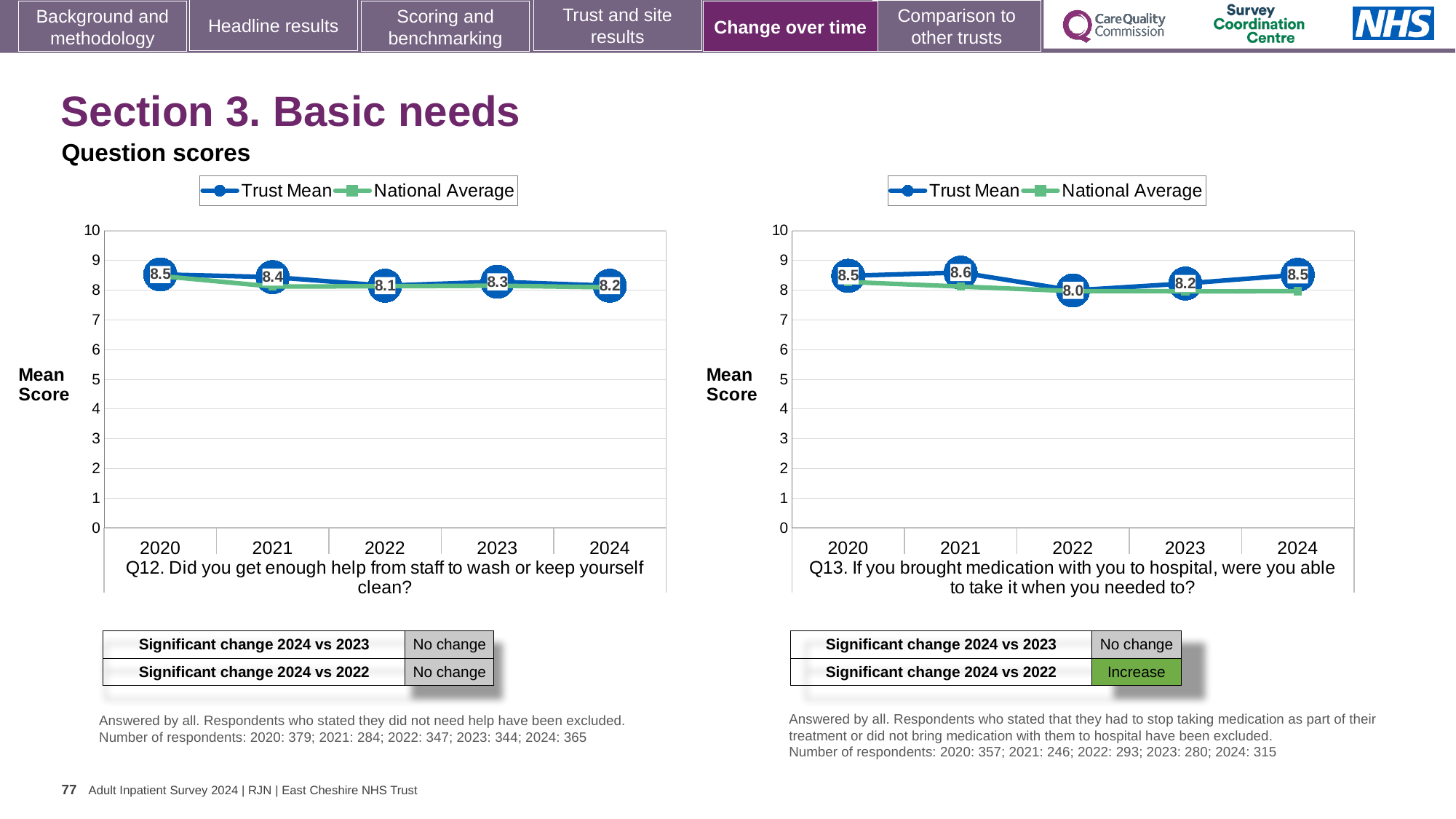
In the Q13 chart, what is the difference between the Trust Mean for 2021 and 2022? 0.6 In the Q12 chart, what is the Trust Mean for 2022? 8.1 In the Q12 chart, is the Trust Mean for 2023 larger or smaller than the Trust Mean for 2022? larger In the Q13 chart, what is the Trust Mean for 2021? 8.6 In the Q12 chart, which year has the highest Trust Mean? 2020 In the Q12 chart, what is the Trust Mean for 2020? 8.5 In the Q13 chart, what is the Trust Mean for 2024? 8.5 How many series does the legend of the Q13 chart list? 2 What type of chart is used for Q12? Line chart In the Q13 chart, is the National Average for 2024 greater or less than 9? less How many years are plotted on the x axis of the Q12 chart? 5 In the Q13 chart, which year has the lowest Trust Mean? 2022